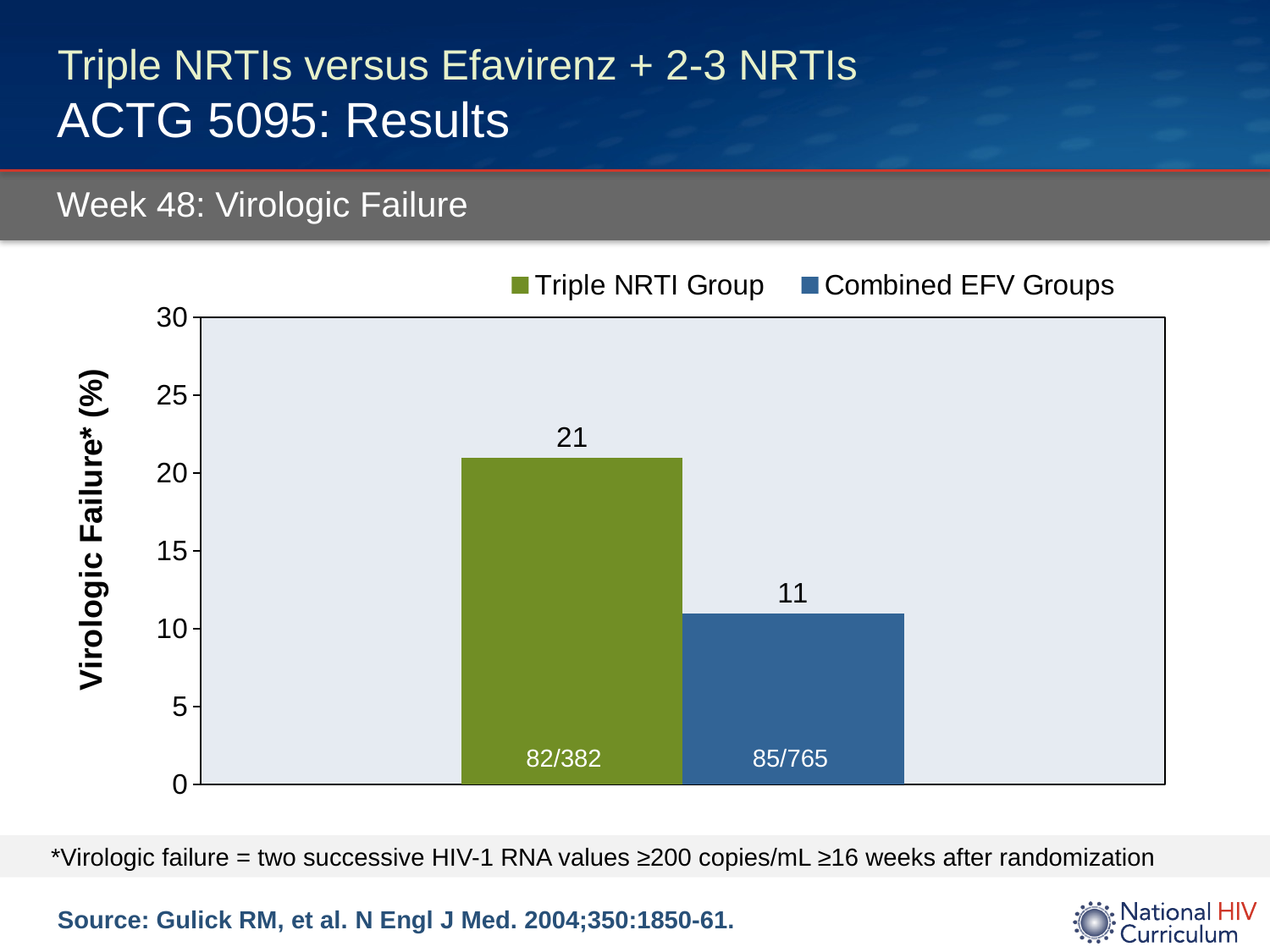
Is the virologic failure rate for the Combined EFV Groups greater or less than 15? less What kind of chart is shown on the slide? Bar chart Which group has the higher virologic failure rate? Triple NRTI Group Which group has the lower virologic failure rate? Combined EFV Groups How many series does the legend list? 2 What fraction is printed inside the Triple NRTI Group bar? 82/382 What is the virologic failure percentage for the Combined EFV Groups? 11 What is the virologic failure percentage for the Triple NRTI Group? 21 Is the virologic failure rate for the Triple NRTI Group greater or less than 20? greater What is the label of the y axis? Virologic Failure* (%) What is the difference in virologic failure percentage between the Triple NRTI Group and the Combined EFV Groups? 10 What fraction is printed inside the Combined EFV Groups bar? 85/765